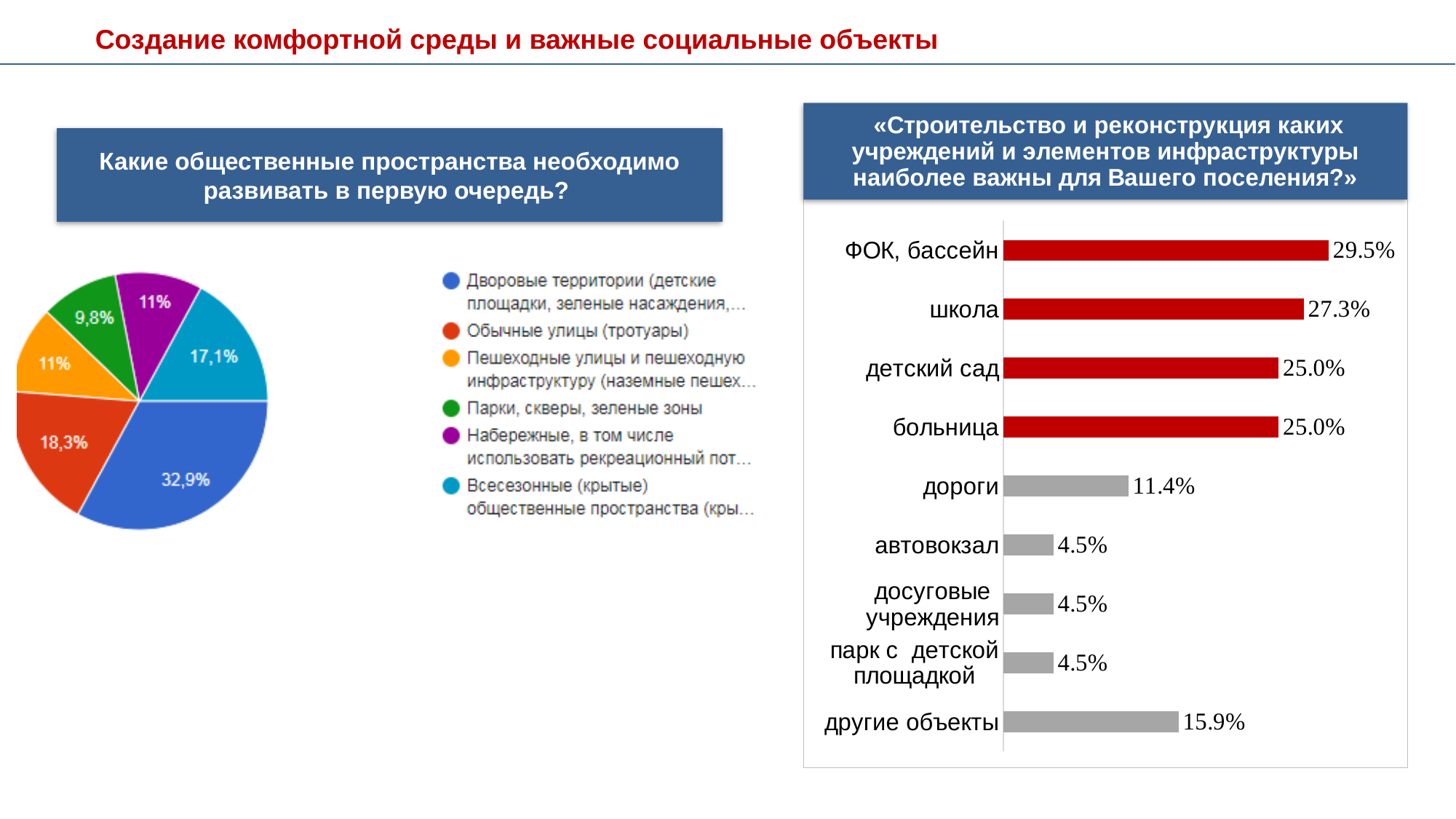
On the right bar chart, which category has the highest value? ФОК, бассейн On the left pie chart, which category has the largest slice? Дворовые территории On the left pie chart, how many categories does the legend list? 6 On the left pie chart, which category has the smallest slice? Парки, скверы, зеленые зоны On the right bar chart, what is the value for «школа»? 27.3% On the left pie chart, which is larger: «Обычные улицы (тротуары)» or «Всесезонные (крытые) общественные пространства»? Обычные улицы (тротуары) On the right bar chart, what is the value for «дороги»? 11.4% On the right bar chart, what is the difference between «ФОК, бассейн» and «школа»? 2.2% On the left pie chart, what share is shown for «Дворовые территории»? 32,9% What type of chart is shown on the right side of the slide? Bar chart On the right bar chart, how many categories are plotted? 9 On the left pie chart, what share is shown for «Парки, скверы, зеленые зоны»? 9,8%